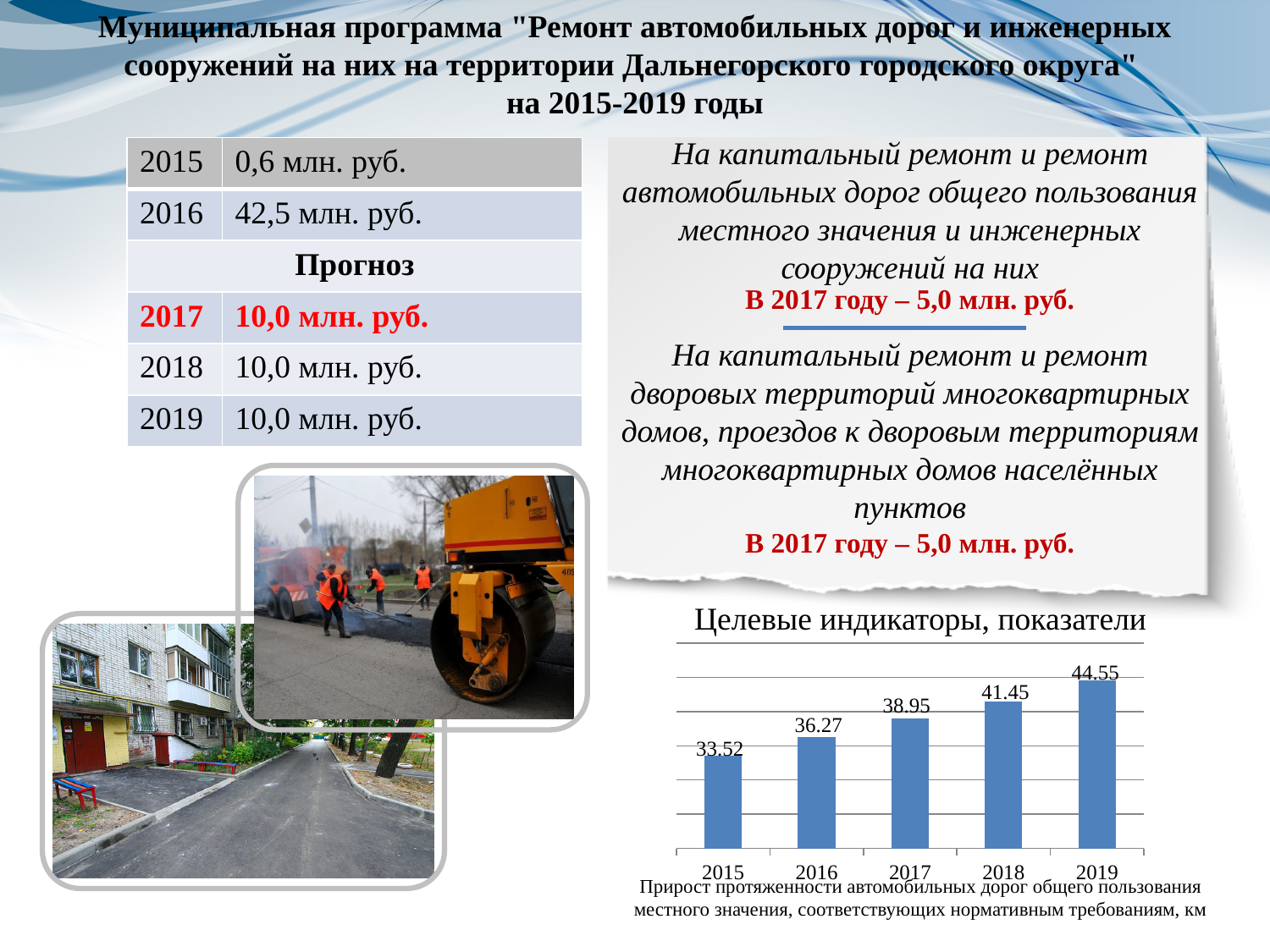
Сколько столбцов (лет) показано на диаграмме? 5 На сколько значение 2017 года больше значения 2016 года? 2.68 На сколько значение 2019 года больше значения 2015 года на диаграмме? 11.03 В каком году на диаграмме самое низкое значение? 2015 Какое значение показано на диаграмме для 2019 года? 44.55 Какого типа диаграмма показана на слайде? Столбчатая (bar chart) Какое значение показано на диаграмме для 2018 года? 41.45 Как меняются значения на диаграмме с 2015 по 2019 год — растут или падают? Растут Какое значение больше на диаграмме: за 2016 или за 2018 год? 2018 Какое значение показано на диаграмме «Целевые индикаторы, показатели» для 2015 года? 33.52 Какое значение показано на диаграмме для 2017 года? 38.95 В каком году на диаграмме самое высокое значение? 2019